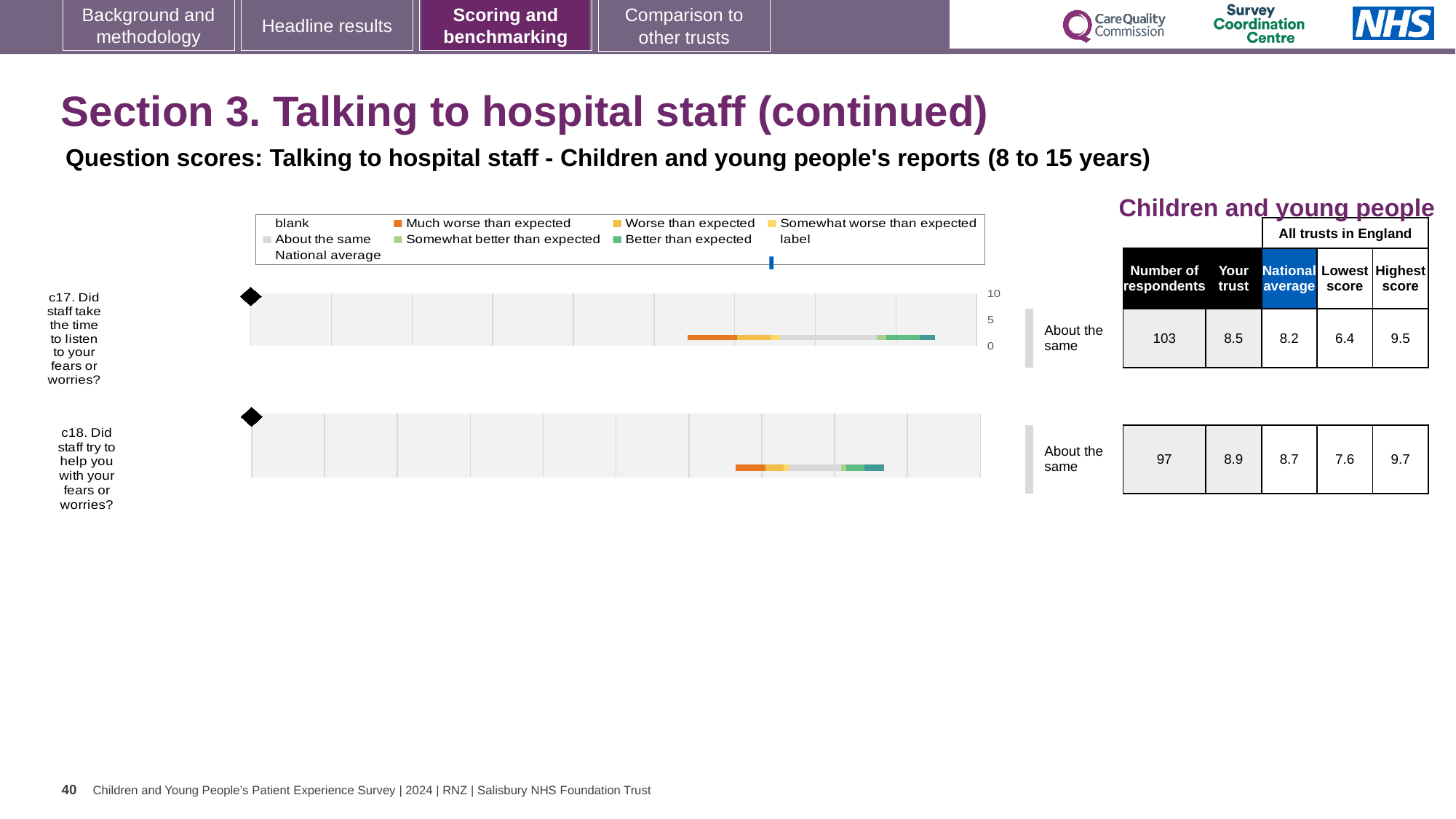
What is the 'Your trust' score for c17 (Did staff take the time to listen to your fears or worries?)? 8.5 What kind of chart is used to show the question scores for c17 and c18? bar chart Which question has the higher 'Your trust' score, c17 or c18? c18 By how much does the trust's score for c18 exceed the national average for c18? 0.2 What is the maximum value shown on the chart's score axis? 10 What benchmark category is shown for c17? About the same What is the national average score for c18 (Did staff try to help you with your fears or worries?)? 8.7 What is the difference between the highest and lowest scores for c17? 3.1 What is the highest score among all trusts in England for c17? 9.5 What is the lowest score among all trusts in England for c18? 7.6 How many respondents answered question c17? 103 How many survey questions are plotted on the slide? 2